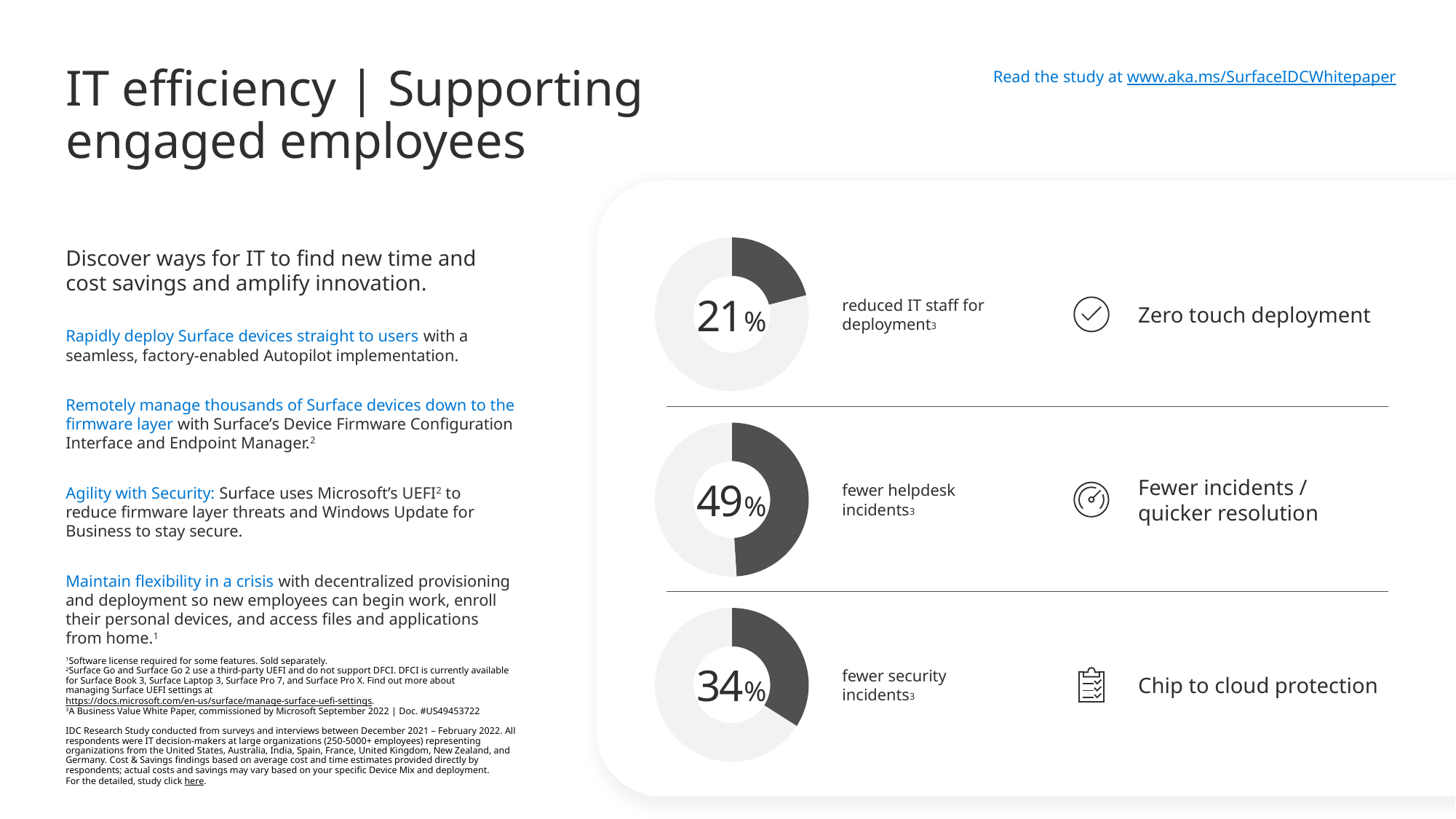
How many donut charts are shown on the slide? 3 Which of the three donut charts shows the highest percentage? fewer helpdesk incidents (49%) What kind of chart is used to show the 21%, 49% and 34% values? donut chart What is the difference between the fewer helpdesk incidents value and the reduced IT staff for deployment value? 28% What colour is the filled segment in each donut chart? dark grey Which is larger: the fewer security incidents value or the reduced IT staff for deployment value? fewer security incidents What value is shown in the bottom donut chart, for fewer security incidents? 34% What label appears to the right of the bottom donut chart? fewer security incidents Which of the three donut charts shows the lowest percentage? reduced IT staff for deployment (21%) What value is shown in the top donut chart, for reduced IT staff for deployment? 21% What value is shown in the middle donut chart, for fewer helpdesk incidents? 49% What is the difference between the fewer helpdesk incidents value and the fewer security incidents value? 15%